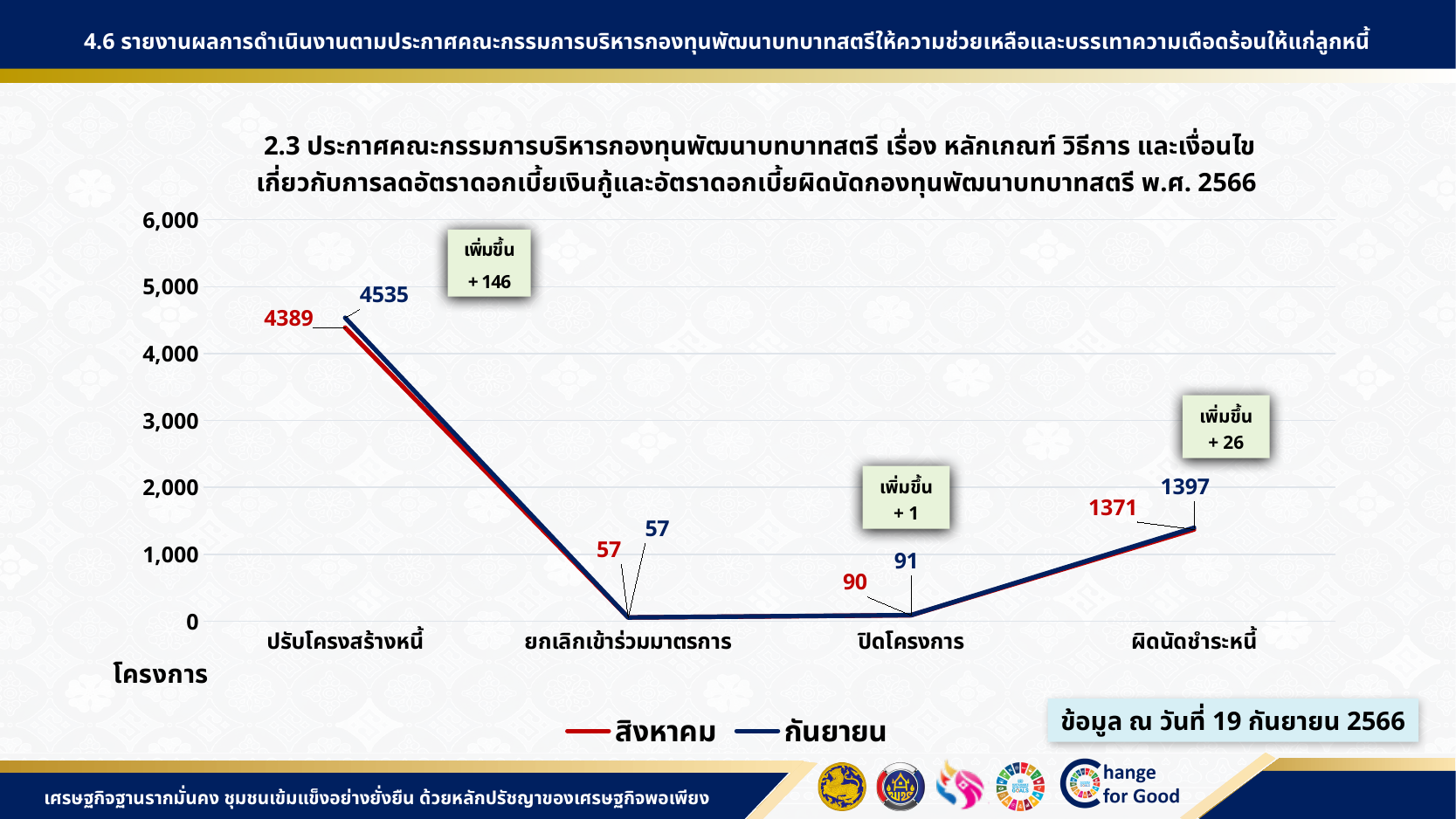
How many series does the legend list? 2 How many categories are shown on the x axis? 4 What is the value for ปรับโครงสร้างหนี้ in the สิงหาคม series? 4389 What is the value for ปรับโครงสร้างหนี้ in the กันยายน series? 4535 What is the value for ผิดนัดชำระหนี้ in the สิงหาคม series? 1371 Which category has the highest value in the กันยายน series? ปรับโครงสร้างหนี้ Which category has the lowest value in the สิงหาคม series? ยกเลิกเข้าร่วมมาตรการ What is the value for ปิดโครงการ in the กันยายน series? 91 Which is larger for ปรับโครงสร้างหนี้: the สิงหาคม value or the กันยายน value? กันยายน Which series is drawn in red? สิงหาคม What is the difference between the กันยายน and สิงหาคม values for ผิดนัดชำระหนี้? 26 What kind of chart is shown on the slide? line chart